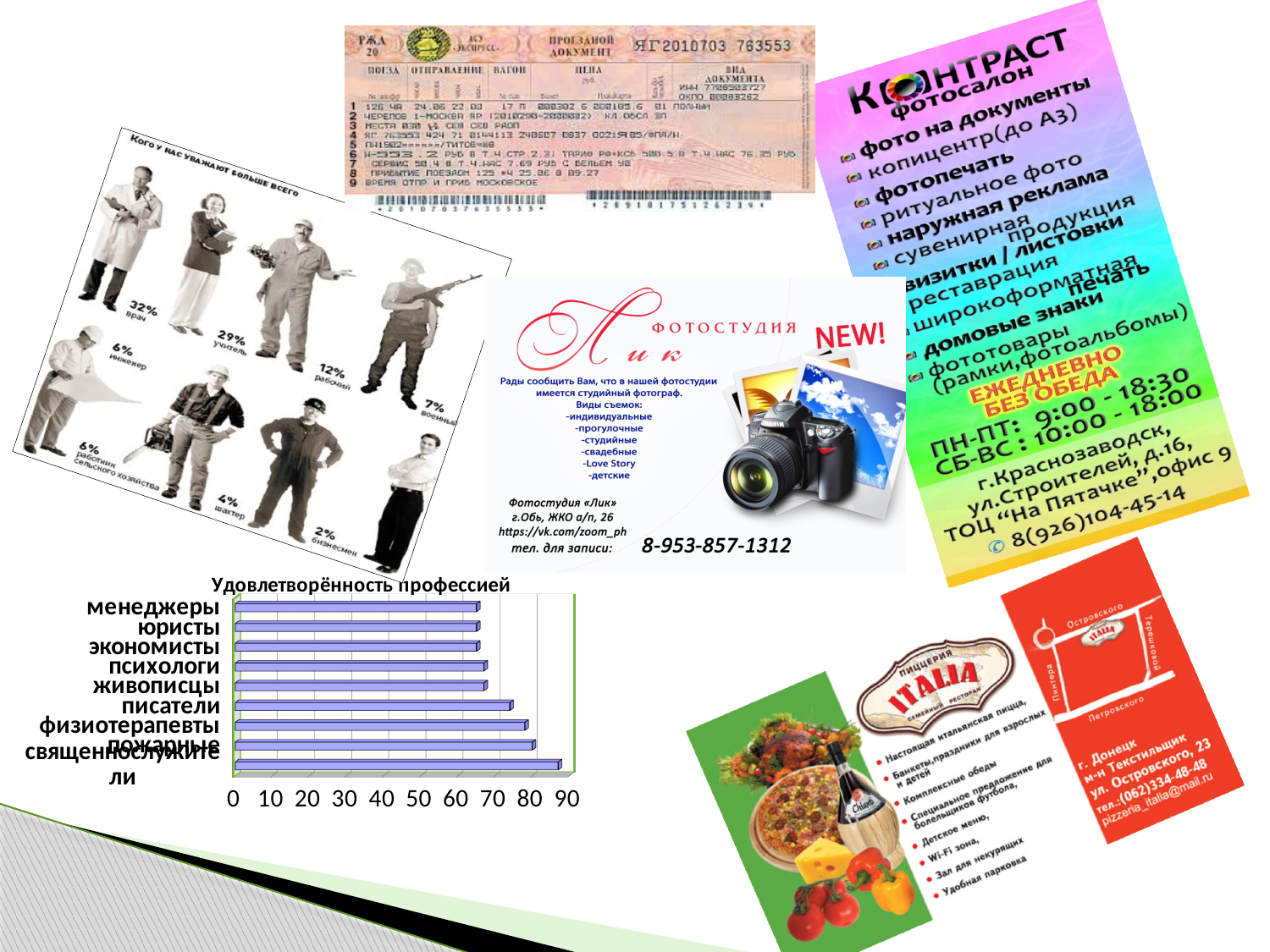
In the "Удовлетворённость профессией" chart, is the value for священнослужители greater or less than 80? greater How many professions are listed in the "Удовлетворённость профессией" chart? 9 In the "Удовлетворённость профессией" chart, which profession has the highest value? священнослужители In the "Удовлетворённость профессией" chart, which is larger: the value for священнослужители or for менеджеры? священнослужители In the "Удовлетворённость профессией" chart, is the value for физиотерапевты greater or less than 70? greater What is the highest tick value shown on the horizontal axis of the "Удовлетворённость профессией" chart? 90 What kind of chart is "Удовлетворённость профессией"? bar chart In the "Удовлетворённость профессией" chart, is the value for пожарные greater or less than 70? greater In the "Удовлетворённость профессией" chart, which is larger: the value for пожарные or for писатели? пожарные What is the title of the bar chart on the slide? Удовлетворённость профессией